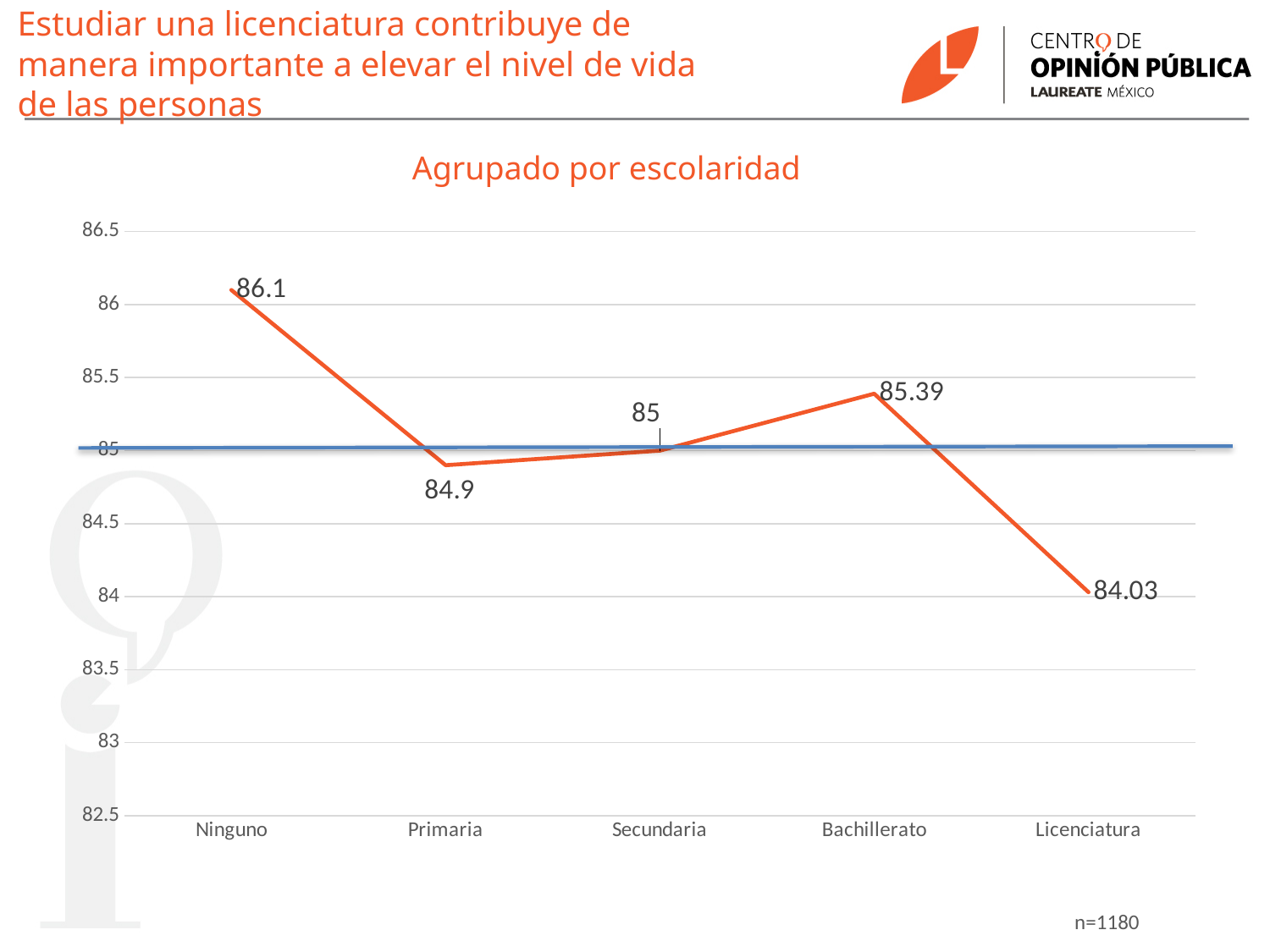
Is the value for Licenciatura greater or less than 84.5? less What is the value for Bachillerato? 85.39 What is the value for Ninguno? 86.1 Which category has the lowest value? Licenciatura What is the title of the chart? Agrupado por escolaridad What is the value for Primaria? 84.9 How many categories are shown on the x axis? 5 Which is larger, the value for Bachillerato or the value for Secundaria? Bachillerato What is the value for Licenciatura? 84.03 What kind of chart is shown on the slide? line chart What is the difference between the values for Ninguno and Licenciatura? 2.07 Which category has the highest value? Ninguno